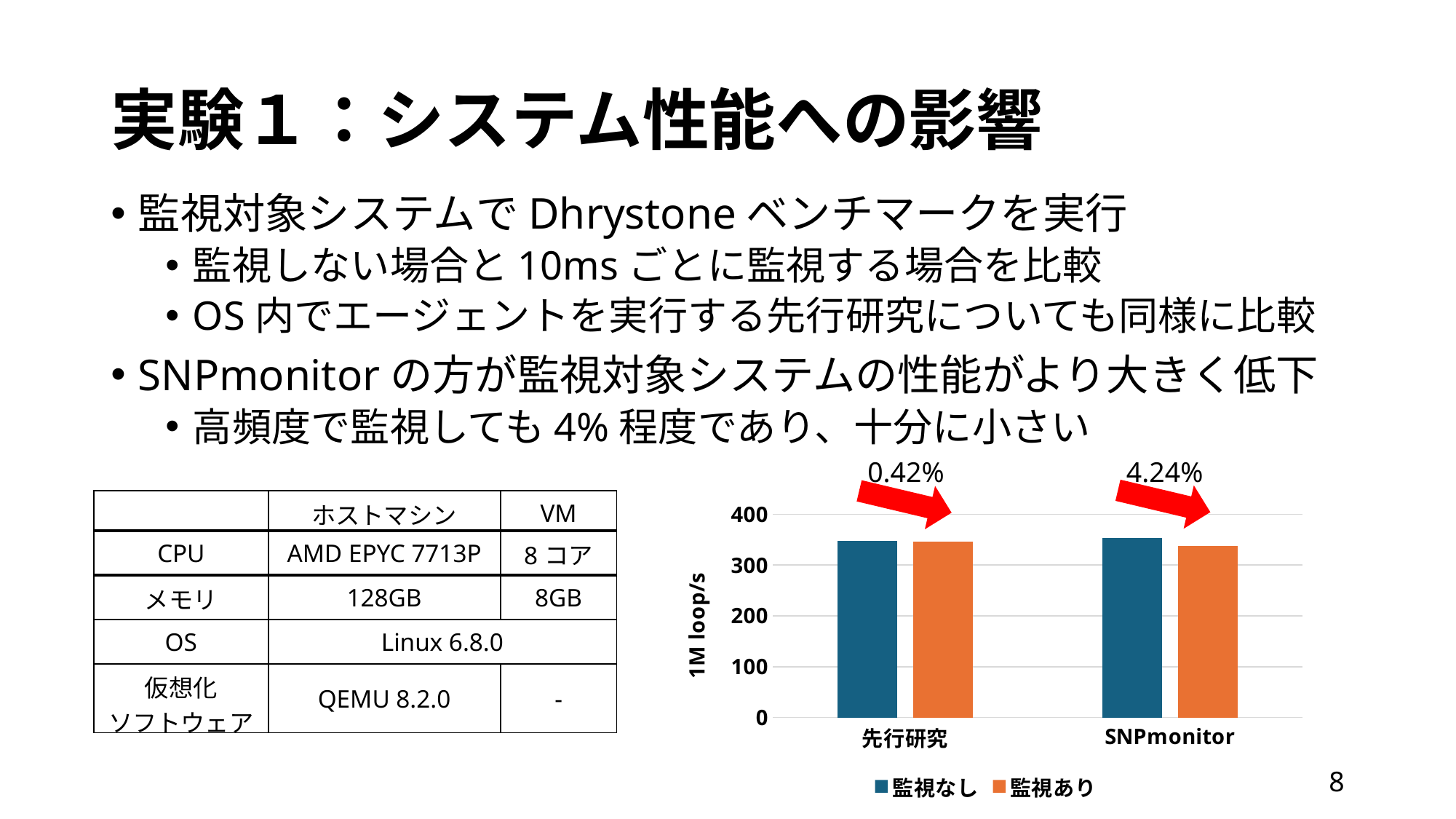
What are the two series listed in the chart legend? 監視なし, 監視あり What is the highest tick value shown on the y axis of the chart? 400 What percentage is annotated above the SNPmonitor bars? 4.24% What kind of chart is shown on the slide? bar chart Is the 監視なし value for SNPmonitor greater or less than 300? greater How many categories are shown on the x axis of the chart? 2 Is the 監視あり value for 先行研究 greater or less than 400? less What percentage is annotated above the 先行研究 bars? 0.42% How many series does the chart legend list? 2 Is the 監視あり value for SNPmonitor greater or less than 200? greater What is the label of the y axis of the chart? 1M loop/s Which category has the larger annotated percentage, 先行研究 or SNPmonitor? SNPmonitor